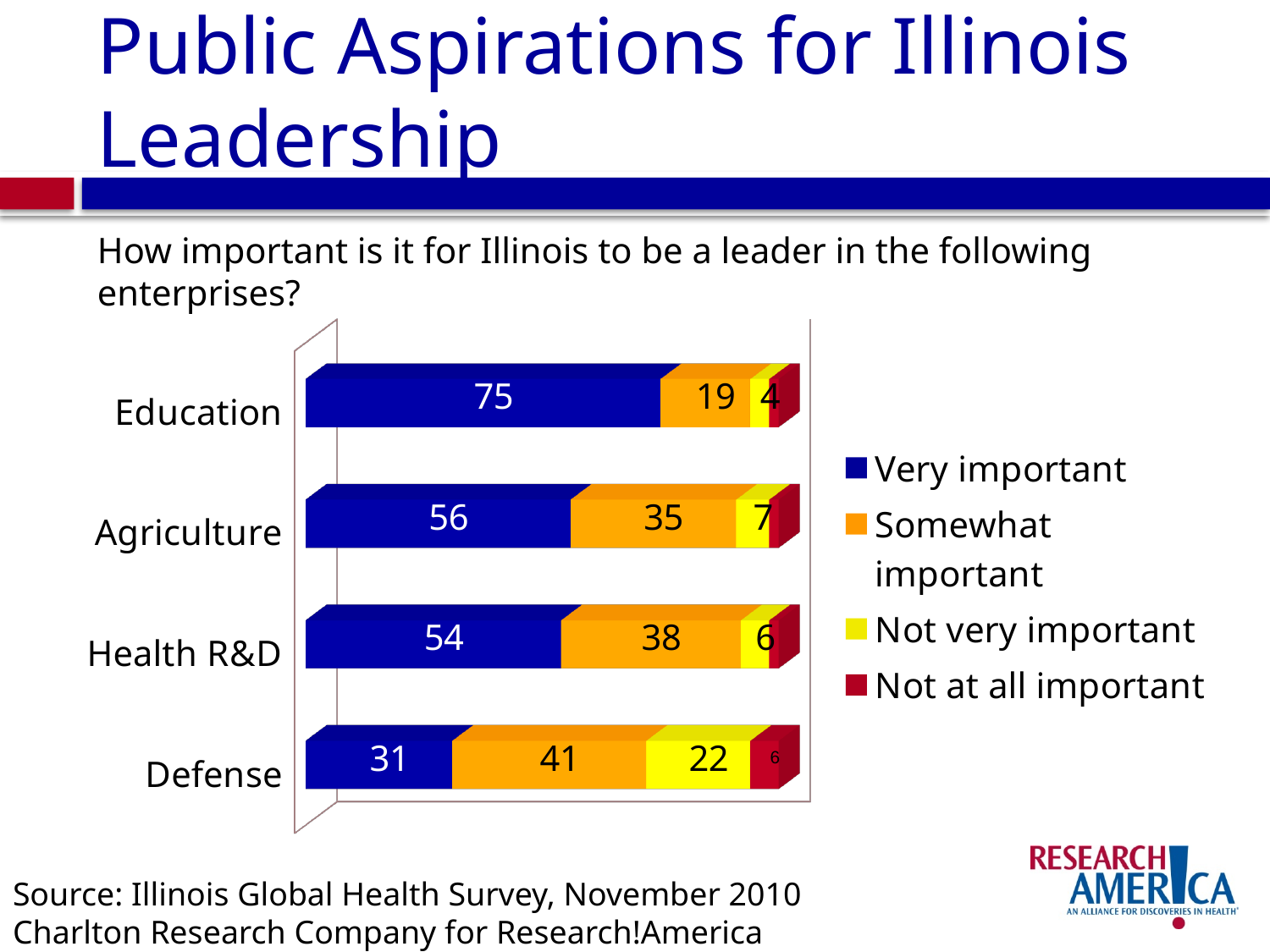
What is the total of the four labelled segments in the Defense bar? 100 What percentage of respondents said it is very important for Illinois to be a leader in Education? 75 Which category has the highest 'Very important' value? Education How many enterprise categories are shown in the chart? 4 What is the 'Not very important' value for Defense? 22 What is the 'Somewhat important' value for Defense? 41 What is the difference between the 'Very important' values for Education and Agriculture? 19 Which colour represents 'Very important' in the legend? Blue Which category has the lowest 'Very important' value? Defense How many series does the legend list? 4 Which has a larger 'Somewhat important' value, Health R&D or Agriculture? Health R&D What kind of chart is shown on the slide? Stacked bar chart